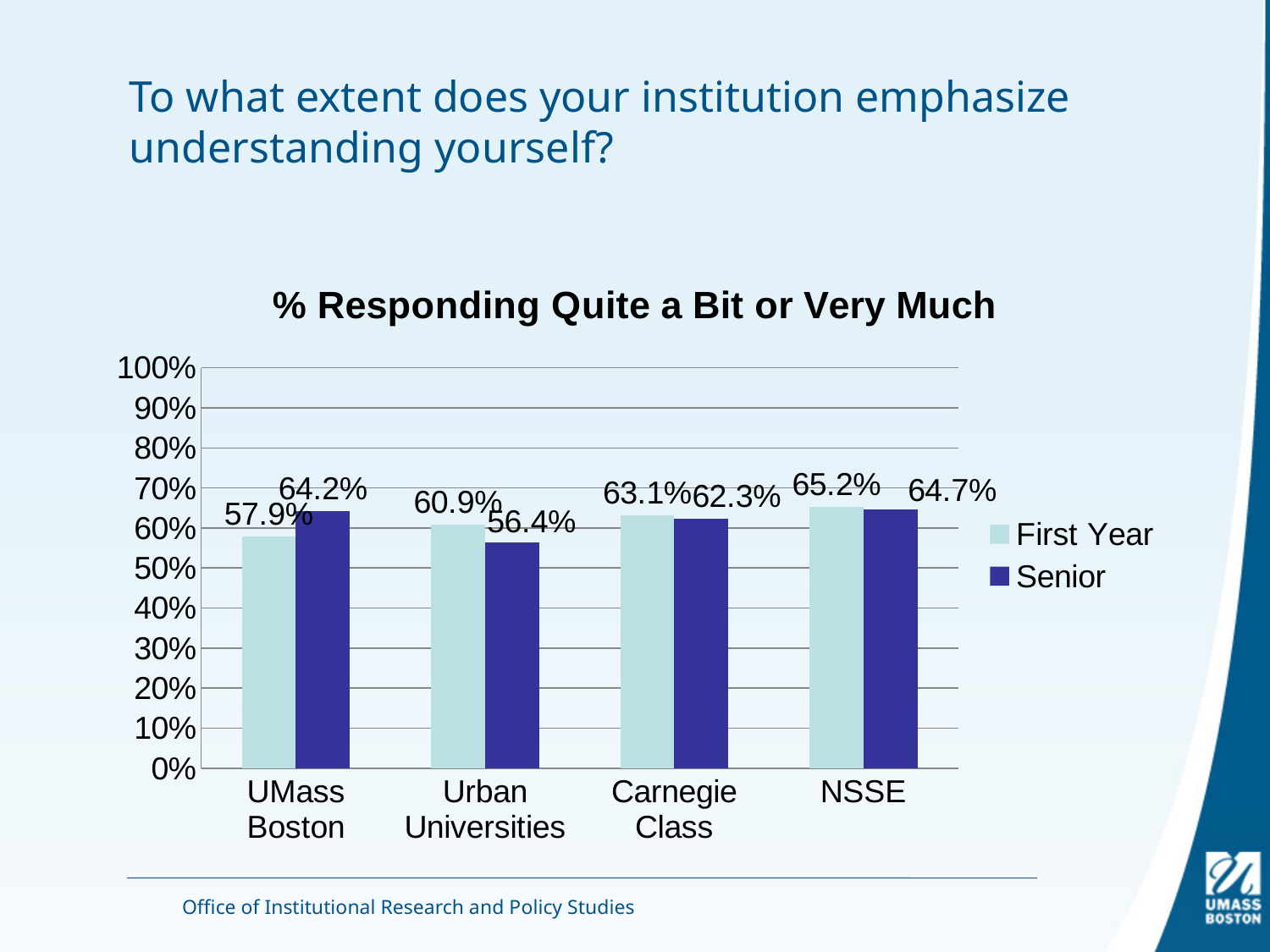
What is the title of the chart? % Responding Quite a Bit or Very Much How many categories are shown on the x axis? 4 How many series does the legend list? 2 What is the difference between the Senior and First Year values for UMass Boston? 6.3% Which category has the highest First Year value? NSSE Is the Senior value for Urban Universities greater or less than 60%? less What is the First Year value for UMass Boston? 57.9% What kind of chart is shown on the slide? bar chart Which category has the lowest Senior value? Urban Universities What is the Senior value for NSSE? 64.7% What is the Senior value for Urban Universities? 56.4% Which is larger for Carnegie Class, the First Year value or the Senior value? First Year